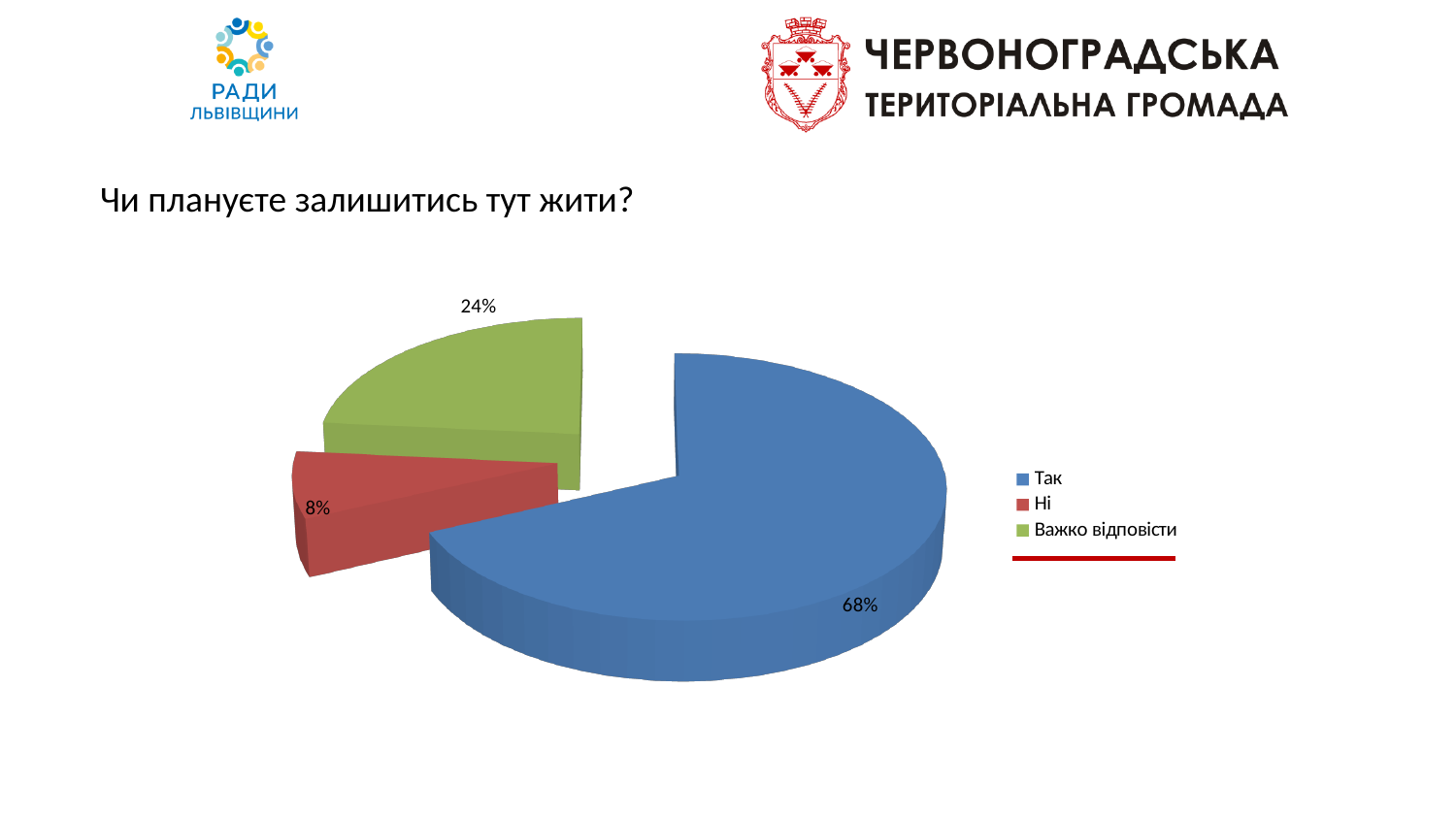
What share of respondents answered "Так"? 68% What share of respondents answered "Важко відповісти"? 24% How many entries does the legend list? 3 What colour is the slice for "Ні"? Red What is the difference in percentage points between "Так" and "Важко відповісти"? 44 Which answer has the largest share of the pie? Так What share of respondents answered "Ні"? 8% Which is larger, the share for "Ні" or the share for "Важко відповісти"? Важко відповісти What is the difference in percentage points between "Важко відповісти" and "Ні"? 16 Which answer has the smallest share of the pie? Ні What kind of chart is shown on the slide? Pie chart How many slices does the pie chart have? 3